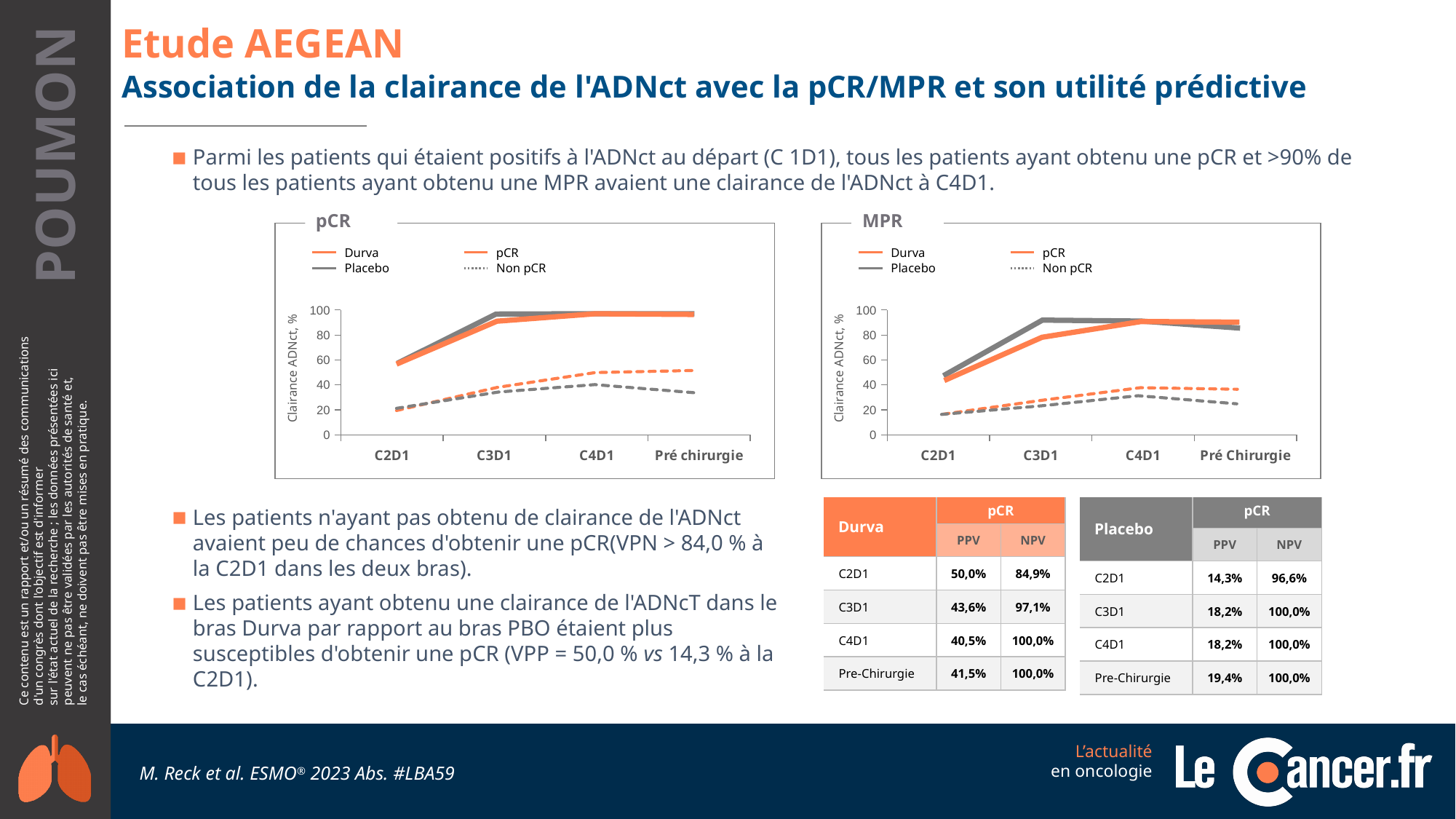
In the MPR chart, is the value of the solid Durva line at C2D1 greater or less than 20? greater How many time points are shown on the x axis of the MPR chart? 4 What kind of chart is the pCR chart? line chart In the pCR chart, is the value of the solid Placebo line at C4D1 greater or less than 80? greater How many entries does the legend of the pCR chart list? 4 In the MPR chart, is the value of the solid Placebo line at C3D1 greater or less than 80? greater In the pCR chart, does the solid Durva line rise or fall from C2D1 to C4D1? rise In the pCR chart at C2D1, which is larger: the solid Durva line or the dashed Durva (Non pCR) line? solid Durva line What is the y-axis label of the MPR chart? Clairance ADNct, %